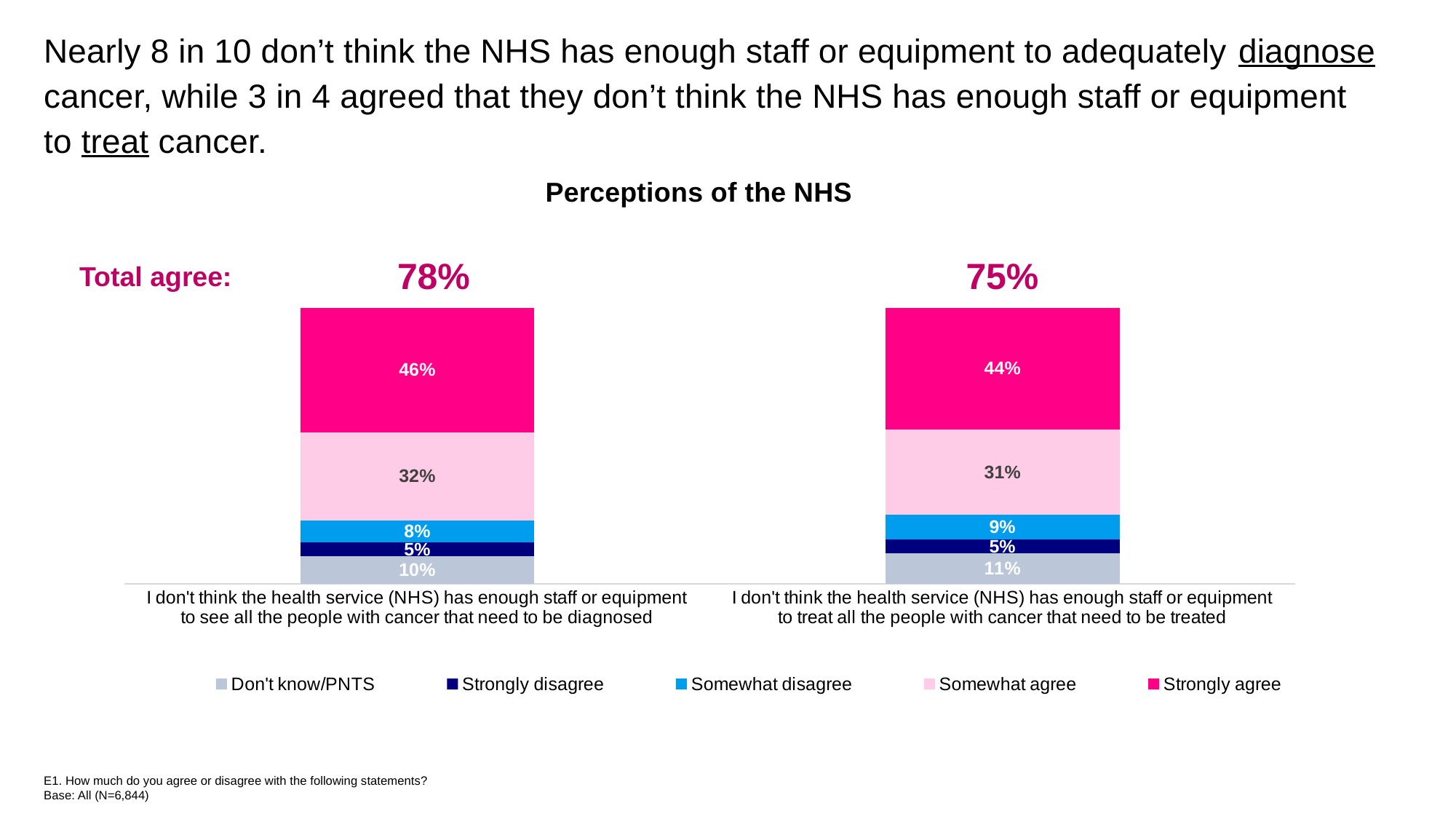
What is the Somewhat disagree value for the statement about diagnosing all the people with cancer? 8% What is the total agree figure shown for the statement about diagnosing cancer? 78% What is the Don't know/PNTS value for the statement about treating all the people with cancer? 11% How many series does the legend list? 5 What percentage strongly agree that the NHS does not have enough staff or equipment to see all the people with cancer that need to be diagnosed? 46% Which series is the largest segment in both bars? Strongly agree What kind of chart is shown on the slide? Stacked bar chart What percentage somewhat agree that the NHS does not have enough staff or equipment to treat all the people with cancer that need to be treated? 31% Which statement has the higher Strongly agree value: the one about diagnosing or the one about treating? Diagnosing What is the title of the chart? Perceptions of the NHS What is the difference between the Strongly agree values for the diagnosing statement and the treating statement? 2% How many statements (categories) are plotted in the chart? 2